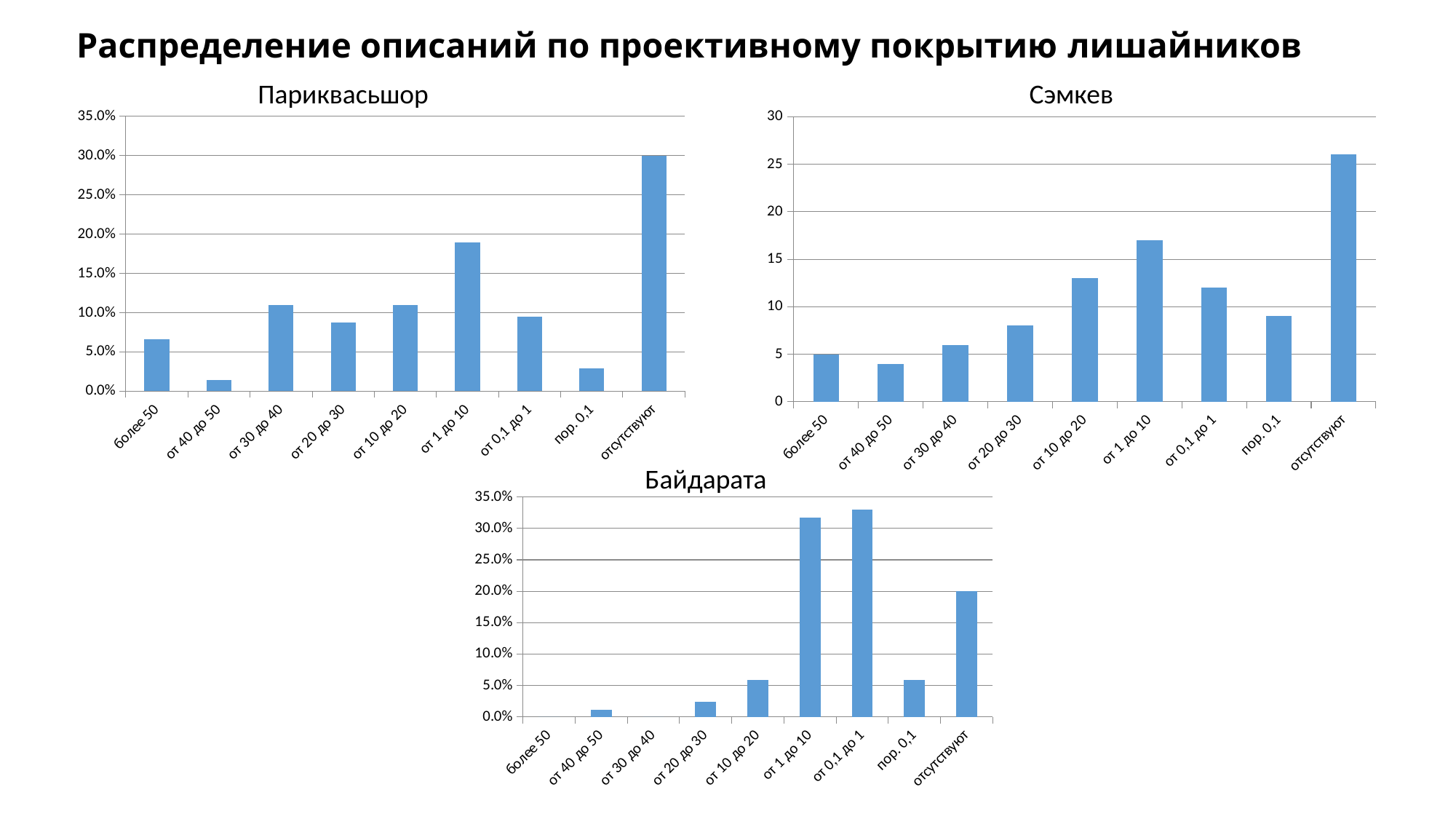
In the Париквасьшор chart, which category has the highest value? отсутствуют In the Сэмкев chart, which category has the highest value? отсутствуют In the Сэмкев chart, what is the value for 'более 50'? 5 In the Байдарата chart, what is the value for 'отсутствуют'? 20.0% In the Байдарата chart, is the value for 'от 1 до 10' greater or less than 30.0%? greater In the Париквасьшор chart, how many categories are shown on the x axis? 9 In the Сэмкев chart, which is larger: the value for 'от 1 до 10' or the value for 'от 10 до 20'? от 1 до 10 In the Париквасьшор chart, is the value for 'от 1 до 10' greater or less than 15.0%? greater In the Париквасьшор chart, which category has the lowest value? от 40 до 50 What kind of chart is the Париквасьшор chart? bar chart In the Сэмкев chart, which category has the lowest value? от 40 до 50 How many charts are shown on the slide? 3